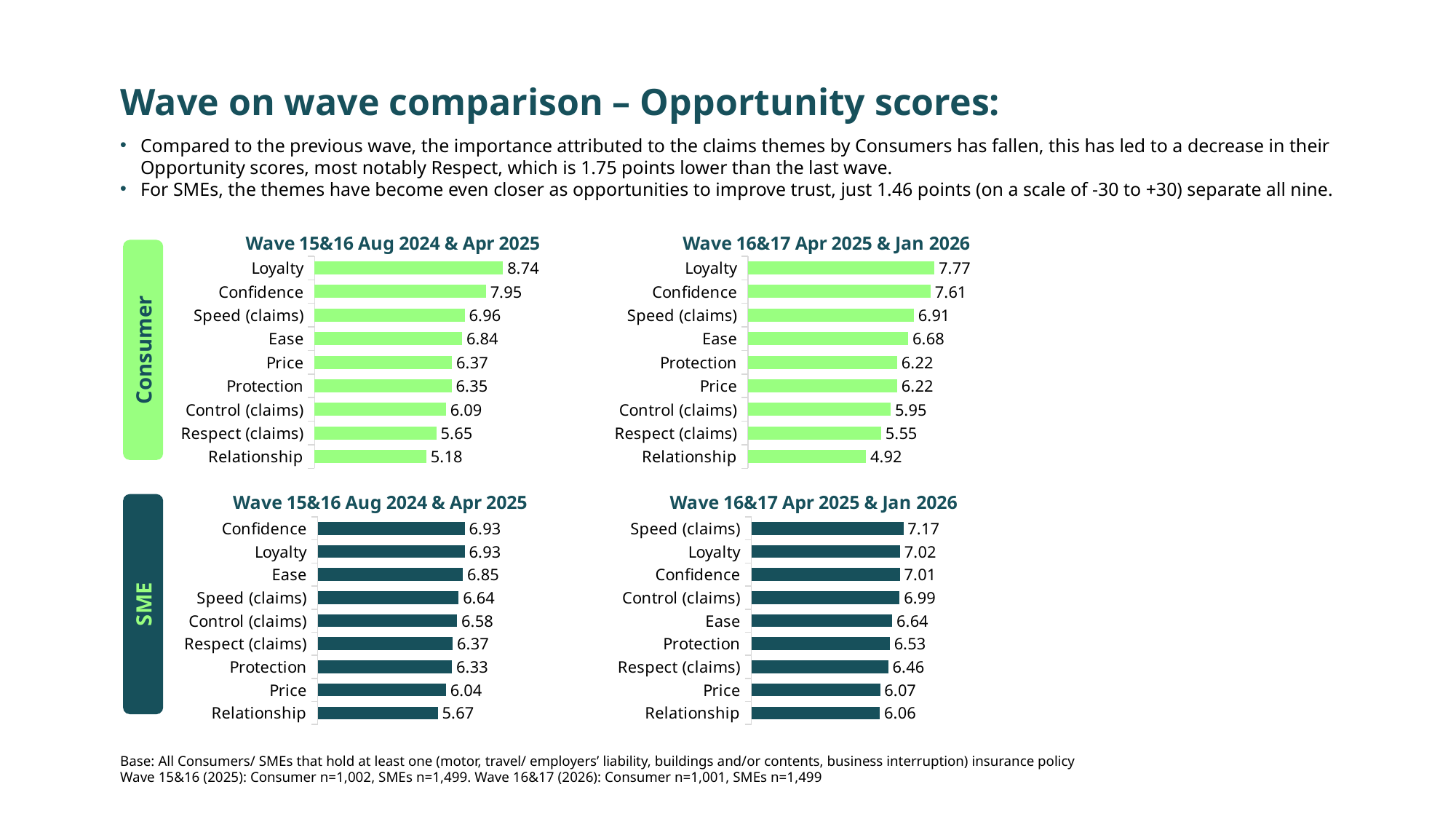
In the Consumer Wave 15&16 Aug 2024 & Apr 2025 chart, what is the value for Respect (claims)? 5.65 In the SME Wave 16&17 Apr 2025 & Jan 2026 chart, what is the difference between Speed (claims) and Relationship? 1.11 How many categories are shown in the SME Wave 16&17 Apr 2025 & Jan 2026 chart? 9 In the Consumer Wave 15&16 Aug 2024 & Apr 2025 chart, what is the value for Loyalty? 8.74 In the Consumer Wave 16&17 Apr 2025 & Jan 2026 chart, what is the difference between Loyalty and Confidence? 0.16 What colour are the bars in the SME charts? Dark teal In the SME Wave 15&16 Aug 2024 & Apr 2025 chart, what is the value for Control (claims)? 6.58 In the SME Wave 16&17 Apr 2025 & Jan 2026 chart, which category has the highest value? Speed (claims) In the SME Wave 15&16 Aug 2024 & Apr 2025 chart, which category has the lowest value? Relationship What type of chart is the Consumer Wave 15&16 Aug 2024 & Apr 2025 chart? Bar chart In the Consumer Wave 16&17 Apr 2025 & Jan 2026 chart, what is the value for Relationship? 4.92 In the Consumer Wave 15&16 Aug 2024 & Apr 2025 chart, which is larger, Price or Protection? Price